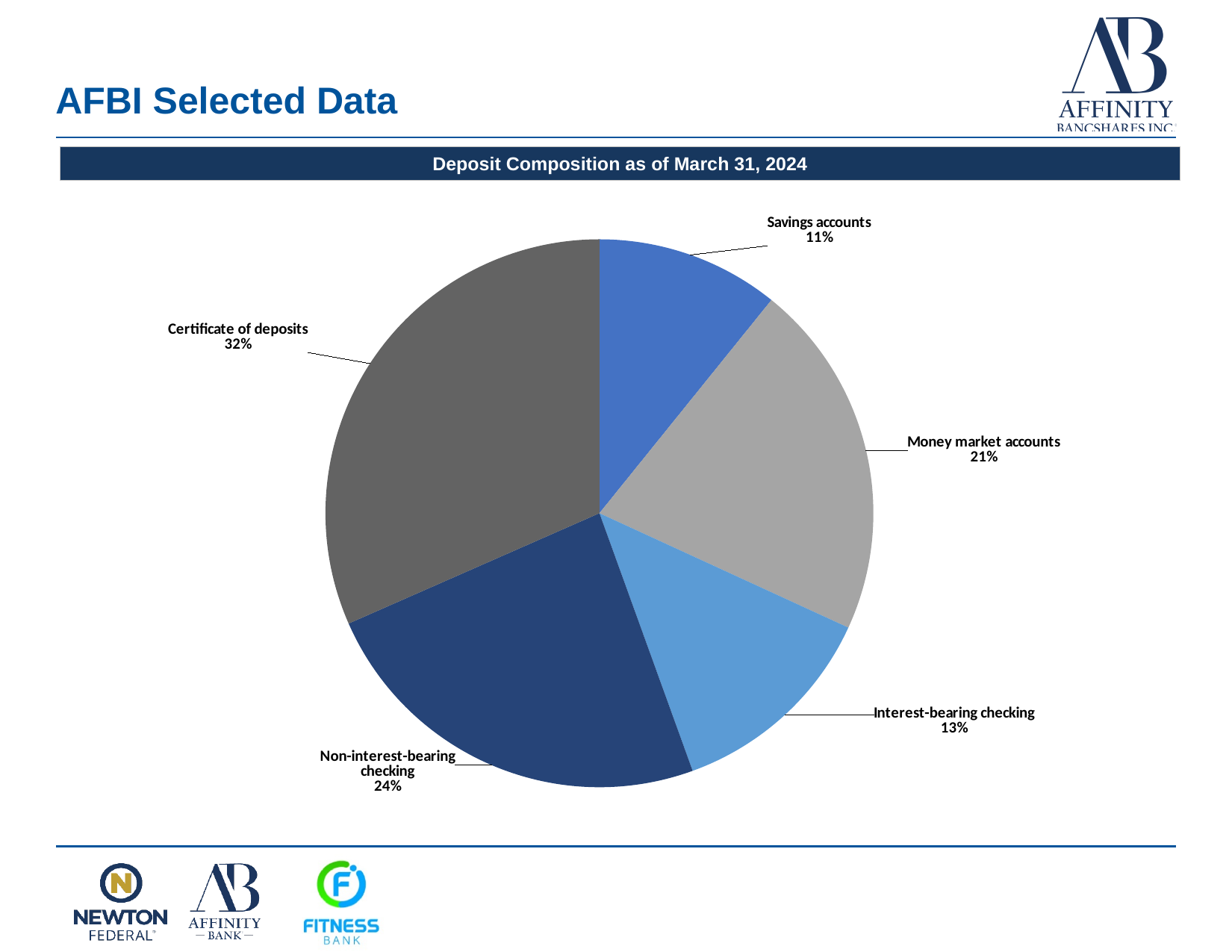
What share of deposits is in certificate of deposits? 32% Which deposit category has the largest share? Certificate of deposits What share of deposits is in non-interest-bearing checking? 24% What is the difference in percentage points between certificate of deposits and non-interest-bearing checking? 8 Which is larger, the share for money market accounts or the share for interest-bearing checking? Money market accounts How many deposit categories are shown in the pie chart? 5 What share of deposits is in interest-bearing checking? 13% What is the title of the chart? Deposit Composition as of March 31, 2024 What kind of chart is shown on the slide? Pie chart Which deposit category has the smallest share? Savings accounts